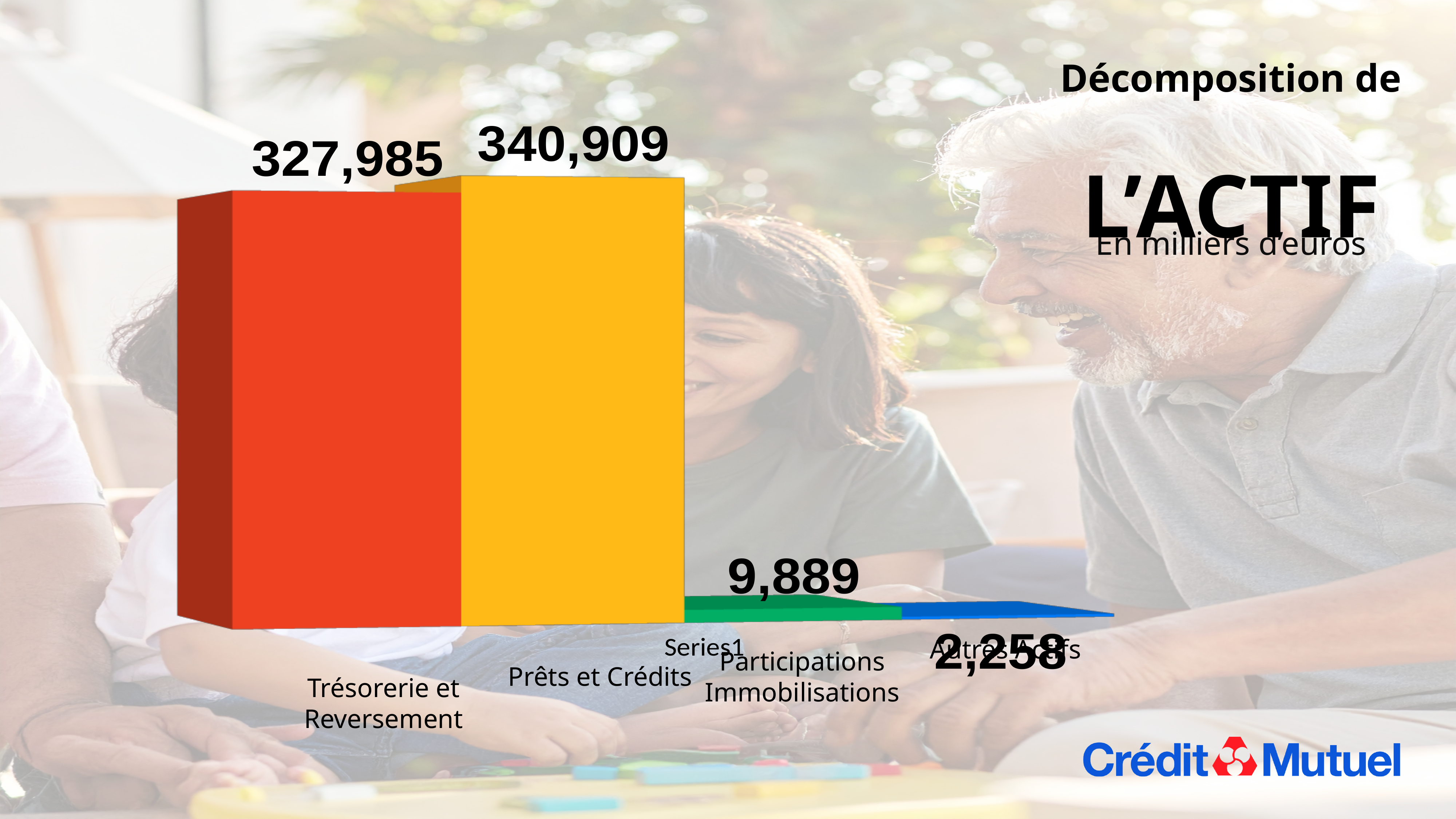
Which category has the lowest value? Autres Actifs In what unit are the chart values expressed, according to the slide? En milliers d'euros What is the difference between the values for Prêts et Crédits and Trésorerie et Reversement? 12,924 Which category has the highest value? Prêts et Crédits What kind of chart is shown on the slide? Bar chart How many categories are shown in the chart? 4 What is the value for Trésorerie et Reversement? 327,985 Which is larger, the value for Prêts et Crédits or the value for Trésorerie et Reversement? Prêts et Crédits What is the difference between the values for Participations Immobilisations and Autres Actifs? 7,631 What is the value for Prêts et Crédits? 340,909 What is the value for Participations Immobilisations? 9,889 What is the value shown for the blue bar (Autres Actifs)? 2,258